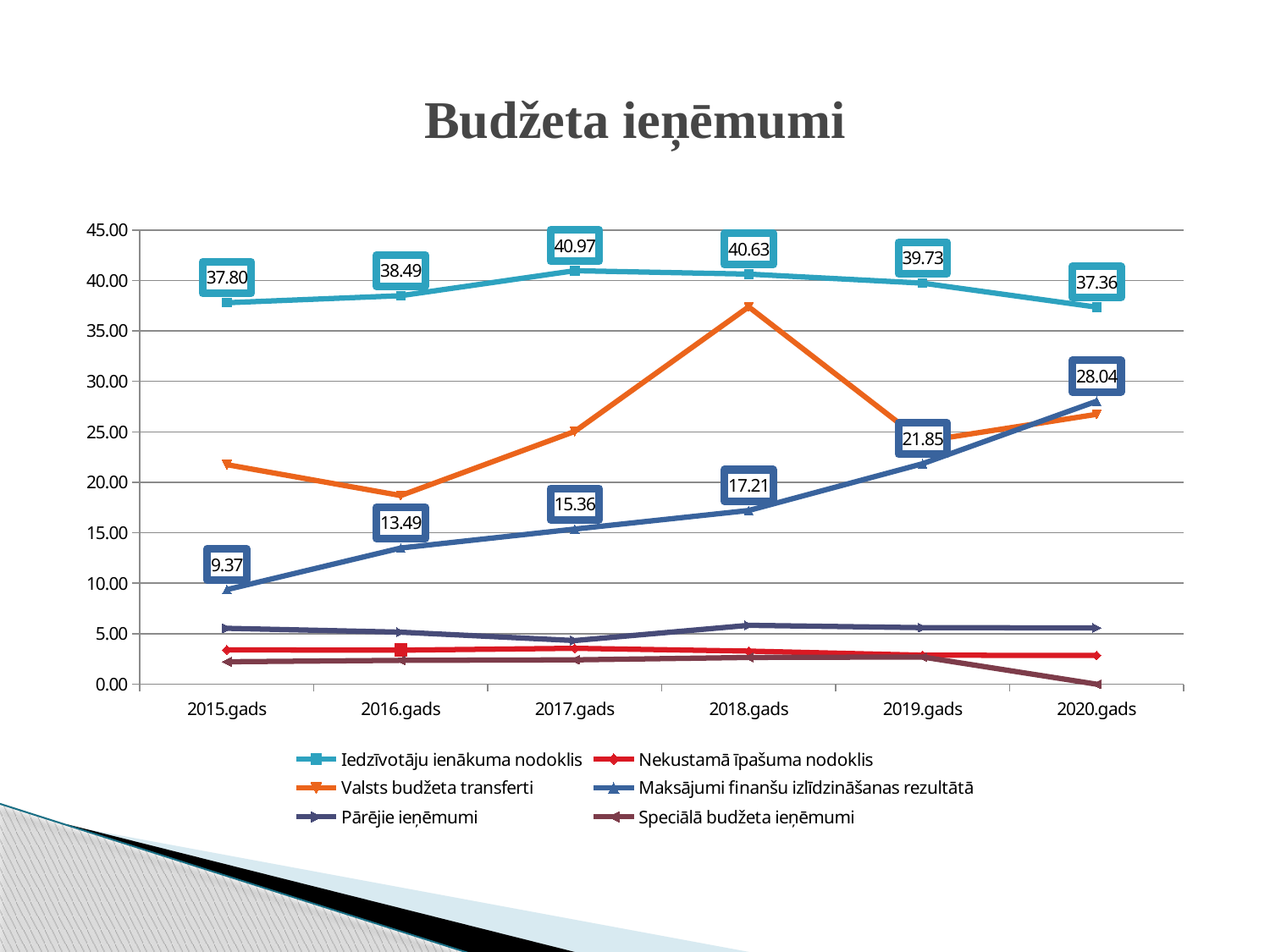
Is the value for Valsts budžeta transferti in 2018.gads greater or less than 35.00? greater Which is larger: Maksājumi finanšu izlīdzināšanas rezultātā in 2019.gads or in 2018.gads? 2019.gads How many series does the legend list? 6 What is the value of Iedzīvotāju ienākuma nodoklis in 2017.gads? 40.97 What kind of chart is shown on the slide? Line chart What is the value of Iedzīvotāju ienākuma nodoklis in 2015.gads? 37.80 What is the difference between the Iedzīvotāju ienākuma nodoklis values for 2017.gads and 2020.gads? 3.61 In which year is Maksājumi finanšu izlīdzināšanas rezultātā lowest? 2015.gads In which year does Iedzīvotāju ienākuma nodoklis reach its highest value? 2017.gads Is the value for Pārējie ieņēmumi in 2016.gads greater or less than 10.00? less What is the value of Maksājumi finanšu izlīdzināšanas rezultātā in 2020.gads? 28.04 How many years are shown on the x axis? 6